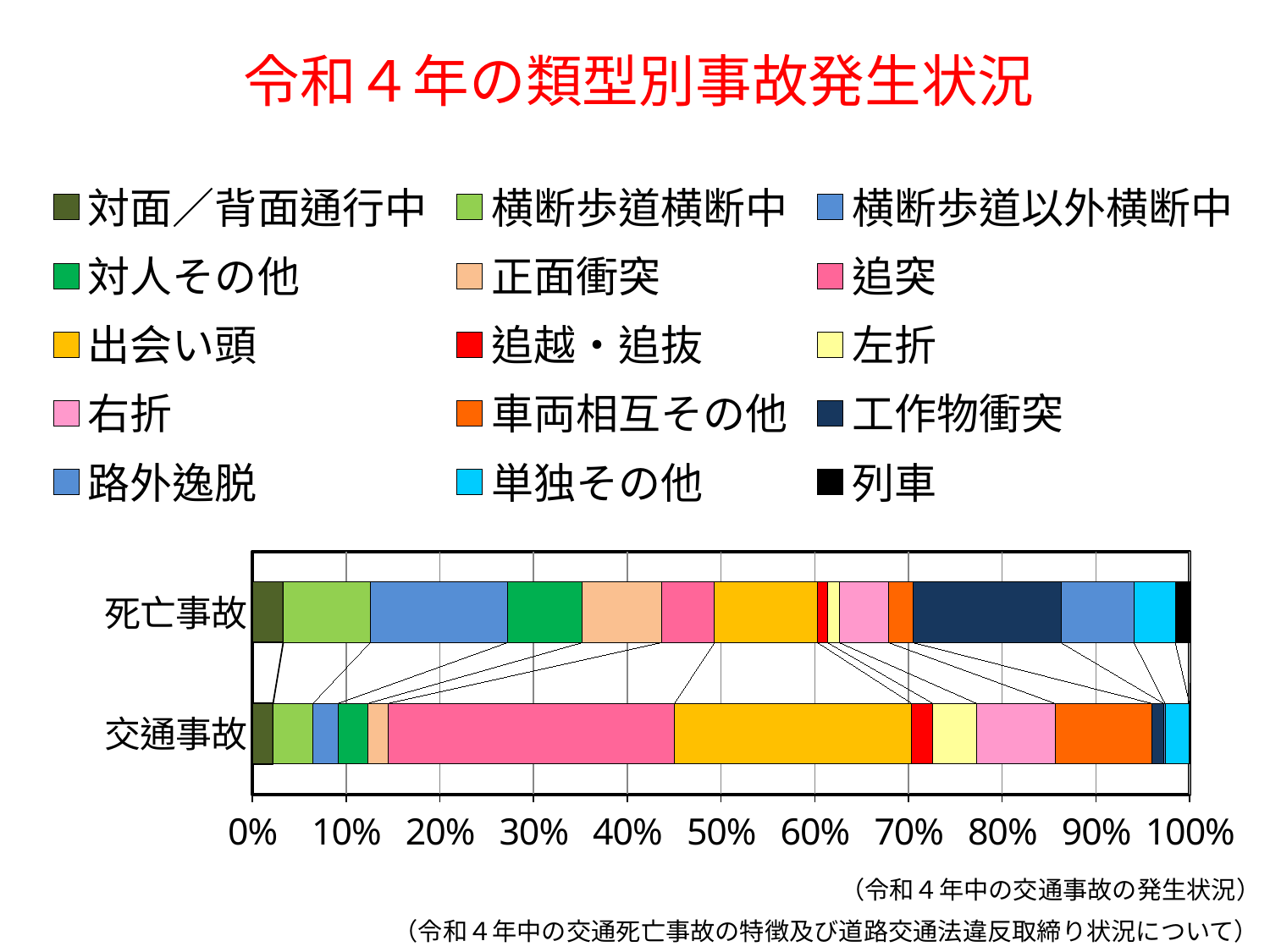
What kind of chart is shown on the slide? stacked bar chart Is the share of 追突 in the 交通事故 bar greater or less than 20%? greater In the 交通事故 bar, which is larger: 追突 or 出会い頭? 追突 What colour represents 列車 in the legend? black What does each stacked bar total on the x axis? 100% How many bars (categories) does the chart show? 2 Is the share of 工作物衝突 in the 死亡事故 bar greater or less than 10%? greater What is the title of the slide? 令和４年の類型別事故発生状況 Is the share of 列車 in the 死亡事故 bar greater or less than 10%? less How many series does the legend list? 15 Which accident type takes the largest share of the 交通事故 bar? 追突 In the 死亡事故 bar, which is larger: 工作物衝突 or 追突? 工作物衝突